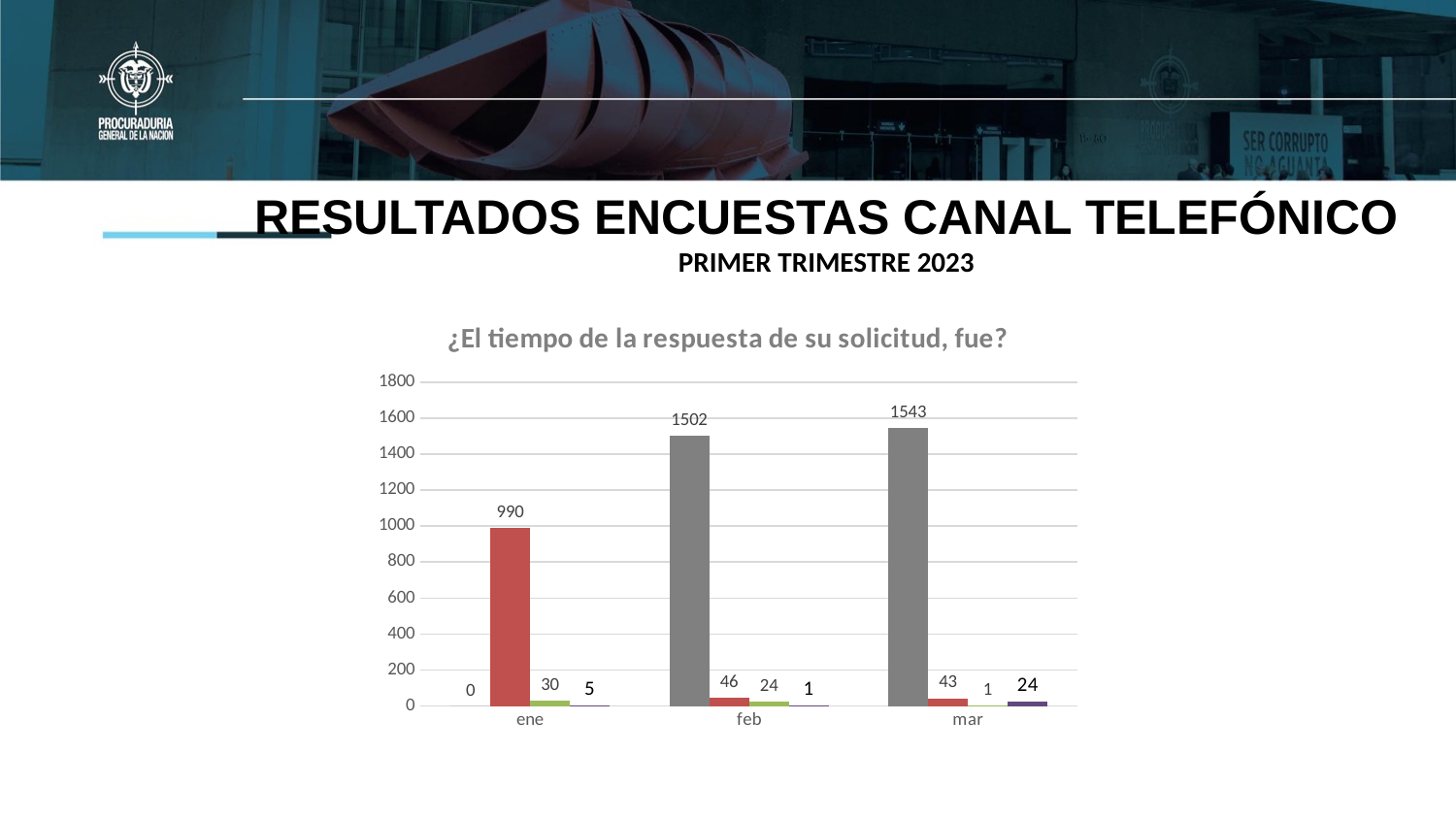
What is the value of the red bar for ene? 990 What is the value of the gray bar for mar? 1543 Is the value of the red bar for ene greater or less than 1000? less Which is larger, the red bar for feb or the red bar for mar? feb What is the difference between the gray bar values for mar and feb? 41 What kind of chart is shown on the slide? bar chart What is the total of the four values shown for ene? 1025 What is the value of the purple bar for mar? 24 How many categories are shown on the x axis of the chart? 3 What is the value of the gray bar for feb? 1502 What is the title of the chart? ¿El tiempo de la respuesta de su solicitud, fue? Which month has the highest gray bar? mar